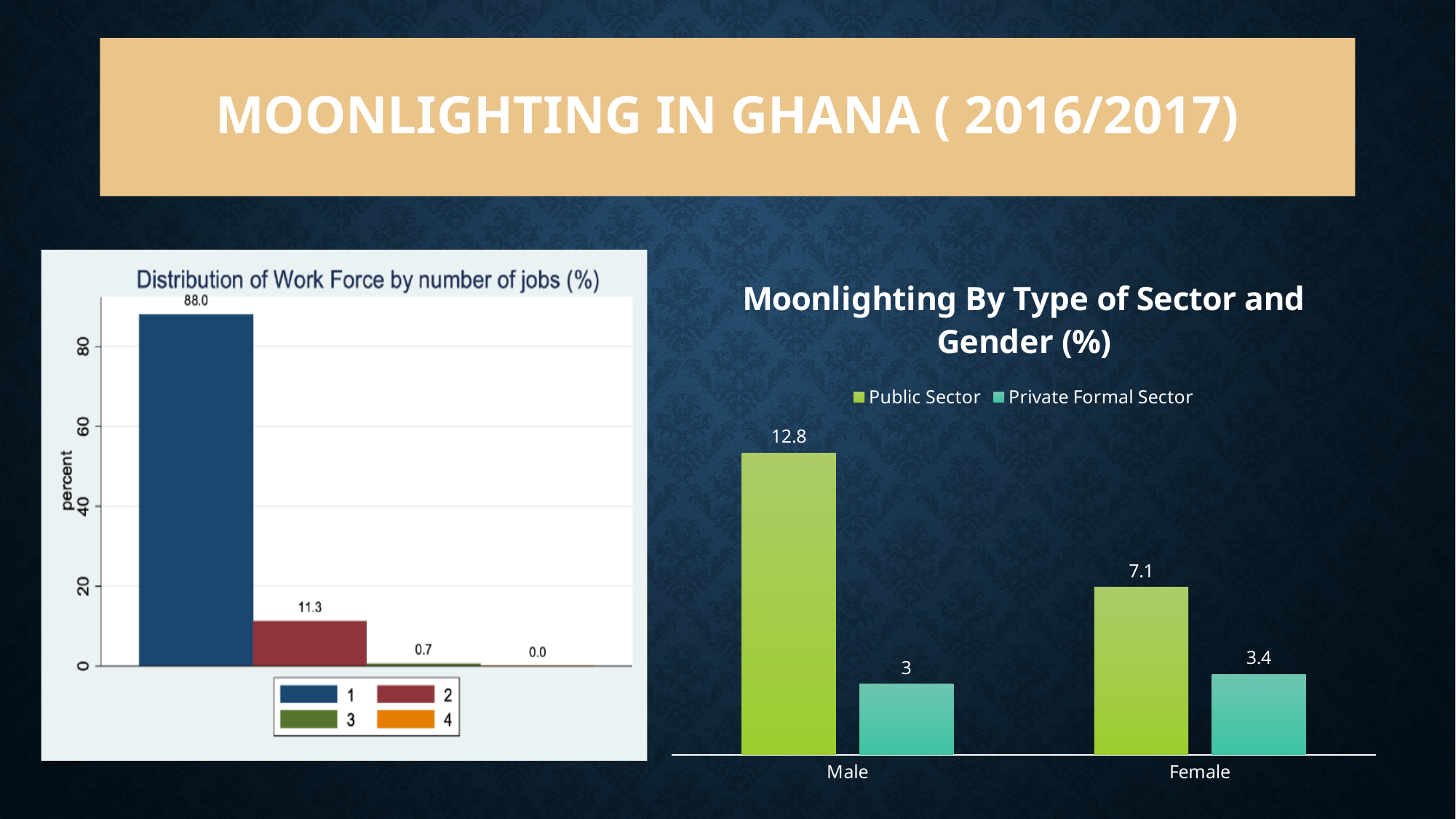
In the 'Distribution of Work Force by number of jobs (%)' chart, what is the value for category 2? 11.3 What kind of chart is the 'Moonlighting By Type of Sector and Gender (%)' chart? Bar chart In the 'Moonlighting By Type of Sector and Gender (%)' chart, what is the Public Sector value for Male? 12.8 In the 'Moonlighting By Type of Sector and Gender (%)' chart, which is larger: the Private Formal Sector value for Male or for Female? Female In the 'Distribution of Work Force by number of jobs (%)' chart, what is the difference between the values for category 1 and category 2? 76.7 In the 'Moonlighting By Type of Sector and Gender (%)' chart, how many series does the legend list? 2 In the 'Distribution of Work Force by number of jobs (%)' chart, what is the value for category 1? 88.0 In the 'Distribution of Work Force by number of jobs (%)' chart, which category has the highest value? 1 In the 'Moonlighting By Type of Sector and Gender (%)' chart, what is the difference between the Public Sector values for Male and Female? 5.7 In the 'Distribution of Work Force by number of jobs (%)' chart, which category has the lowest value? 4 In the 'Distribution of Work Force by number of jobs (%)' chart, how many categories does the legend list? 4 In the 'Moonlighting By Type of Sector and Gender (%)' chart, what is the Private Formal Sector value for Female? 3.4